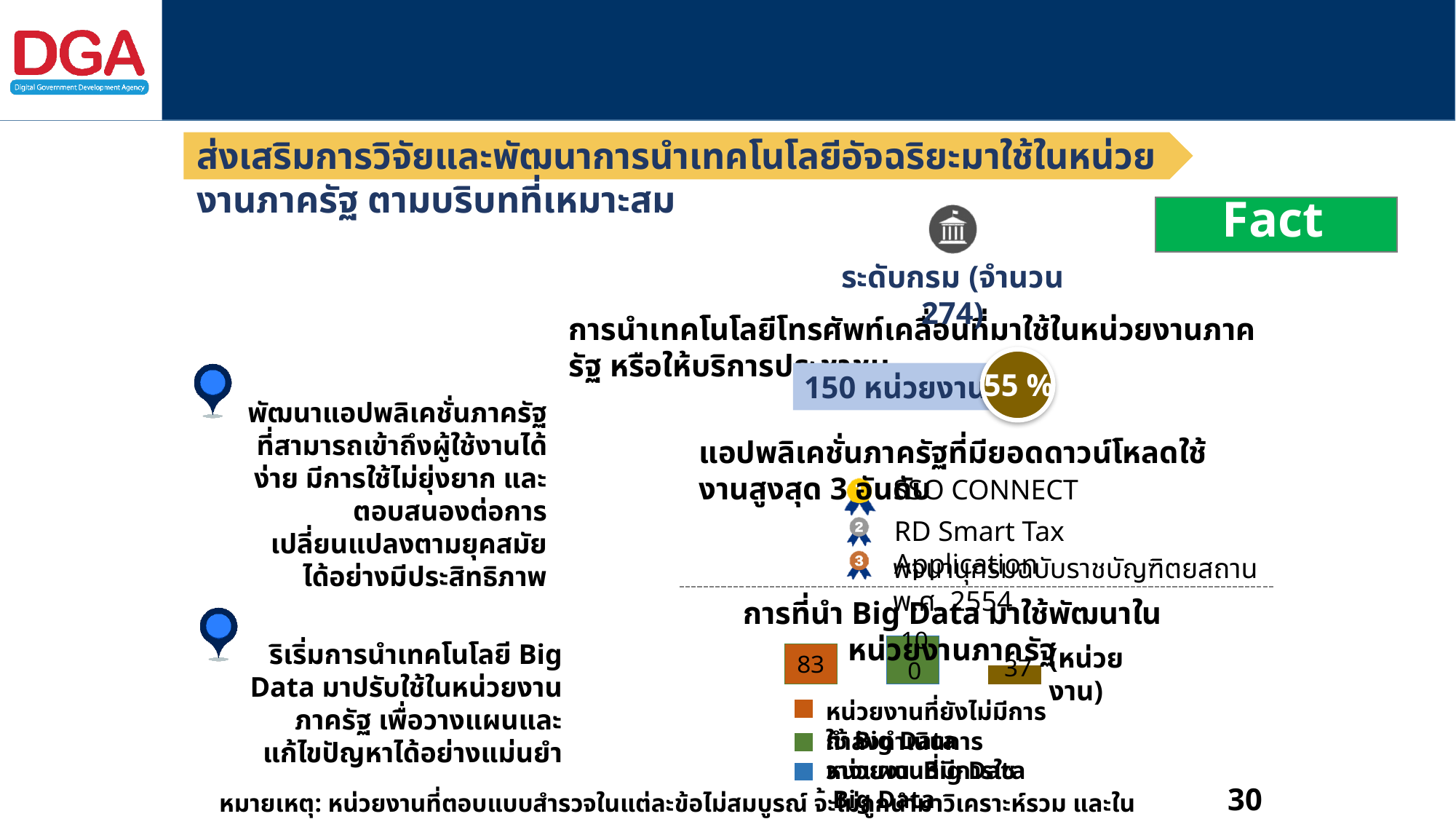
How many bars does the Big Data bar chart have? 3 In the Big Data bar chart, what value is printed on the green (middle) bar? 100 In the Big Data bar chart, which bar has the lowest value? the rightmost (olive) bar, 37 In the Big Data bar chart, what is the difference between the green bar (100) and the orange bar (83)? 17 What colour is the leftmost bar in the Big Data bar chart? orange In the Big Data bar chart, what is the difference between the orange bar (83) and the rightmost bar (37)? 46 In the Big Data bar chart, what value is printed on the rightmost (olive) bar? 37 In the Big Data bar chart, what is the total of the three bar values (83, 100 and 37)? 220 In the Big Data bar chart, which is larger: the orange bar or the rightmost olive bar? the orange bar (83) What kind of chart is shown at the bottom right of the slide under the heading about Big Data? bar chart In the Big Data bar chart, what value is printed on the orange (leftmost) bar? 83 In the Big Data bar chart, which bar has the highest value? the green (middle) bar, 100